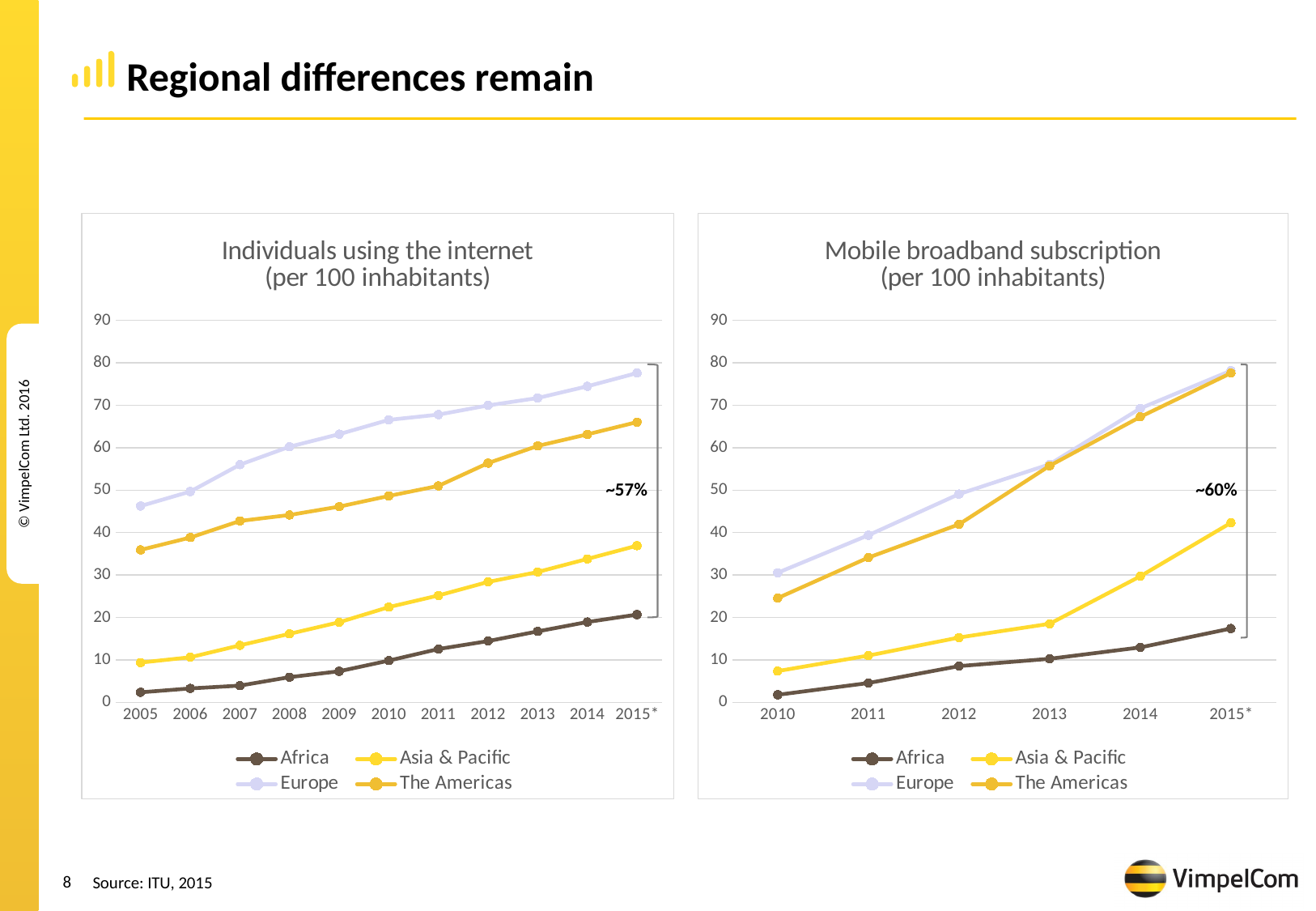
How many years are plotted along the x axis of the "Mobile broadband subscription (per 100 inhabitants)" chart? 6 In the "Mobile broadband subscription (per 100 inhabitants)" chart, which region has the lowest value in 2015*? Africa In the "Individuals using the internet (per 100 inhabitants)" chart, which region has the highest value in 2015*? Europe In the "Mobile broadband subscription (per 100 inhabitants)" chart, does the Asia & Pacific line rise or fall from 2010 to 2015*? rise In the "Individuals using the internet (per 100 inhabitants)" chart, is the value for Europe in 2015* greater or less than 70? greater What percentage gap is annotated on the right side of the "Mobile broadband subscription (per 100 inhabitants)" chart? ~60% How many years are plotted along the x axis of the "Individuals using the internet (per 100 inhabitants)" chart? 11 In the "Mobile broadband subscription (per 100 inhabitants)" chart, is the value for The Americas in 2010 greater or less than 30? less How many series does the legend of the "Mobile broadband subscription (per 100 inhabitants)" chart list? 4 In the "Individuals using the internet (per 100 inhabitants)" chart, is the value for Africa in 2005 greater or less than 10? less What kind of chart is "Individuals using the internet (per 100 inhabitants)"? line chart In the "Individuals using the internet (per 100 inhabitants)" chart, which is larger in 2010: The Americas or Asia & Pacific? The Americas